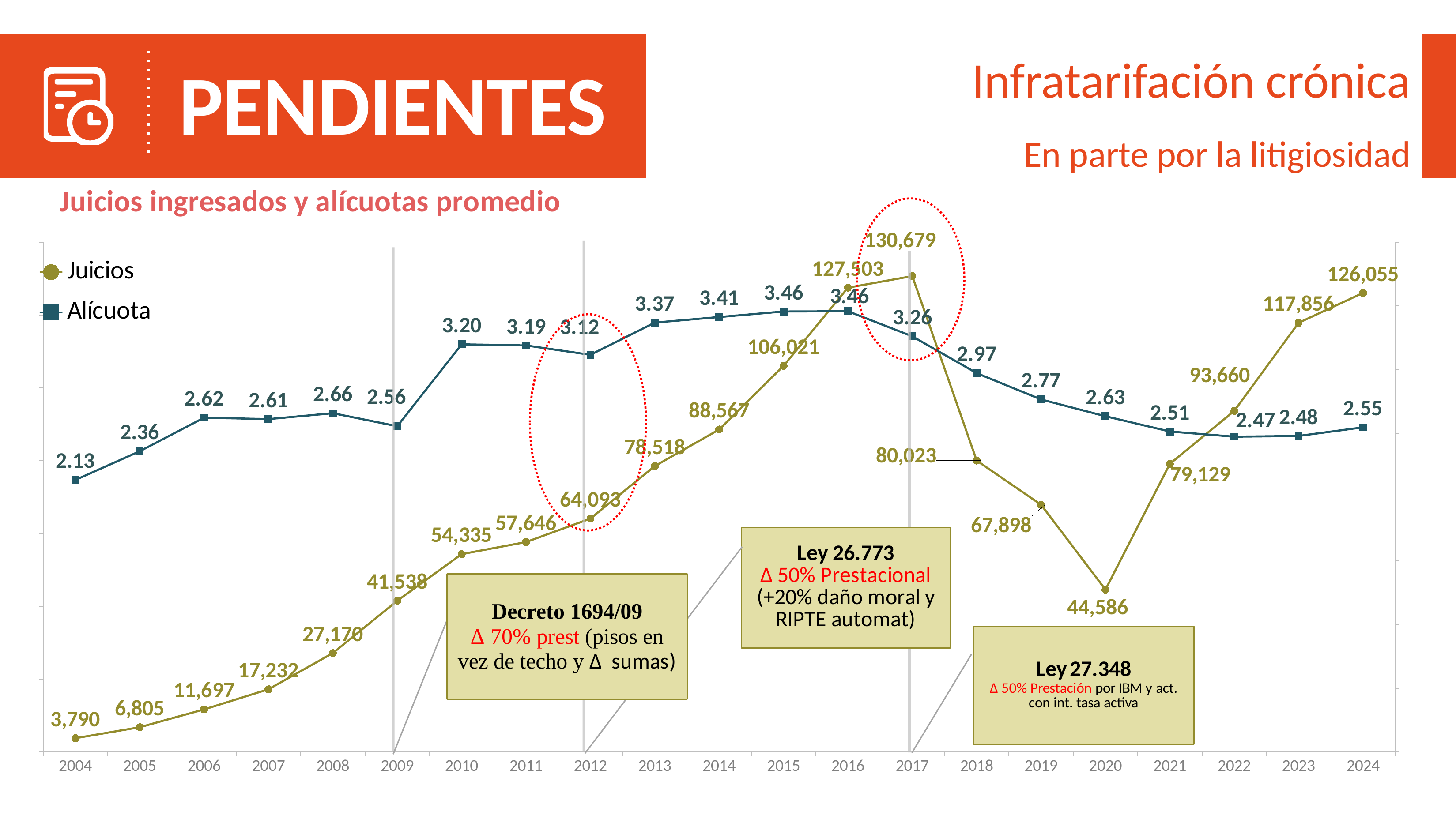
What is the Juicios value for 2017? 130,679 What is the Alícuota value for 2012? 3.12 What kind of chart is shown on the slide? Line chart How many series does the legend list? 2 How many years are shown on the x axis? 21 What is the difference between the Juicios values for 2017 and 2018? 50,656 In which year is the Juicios series highest? 2017 What is the Juicios value for 2020? 44,586 What is the Alícuota value for 2024? 2.55 In which year is the Alícuota series lowest? 2004 Does the Alícuota series rise or fall from 2016 to 2022? Fall Which is larger, the Juicios value for 2016 or for 2024? 2016